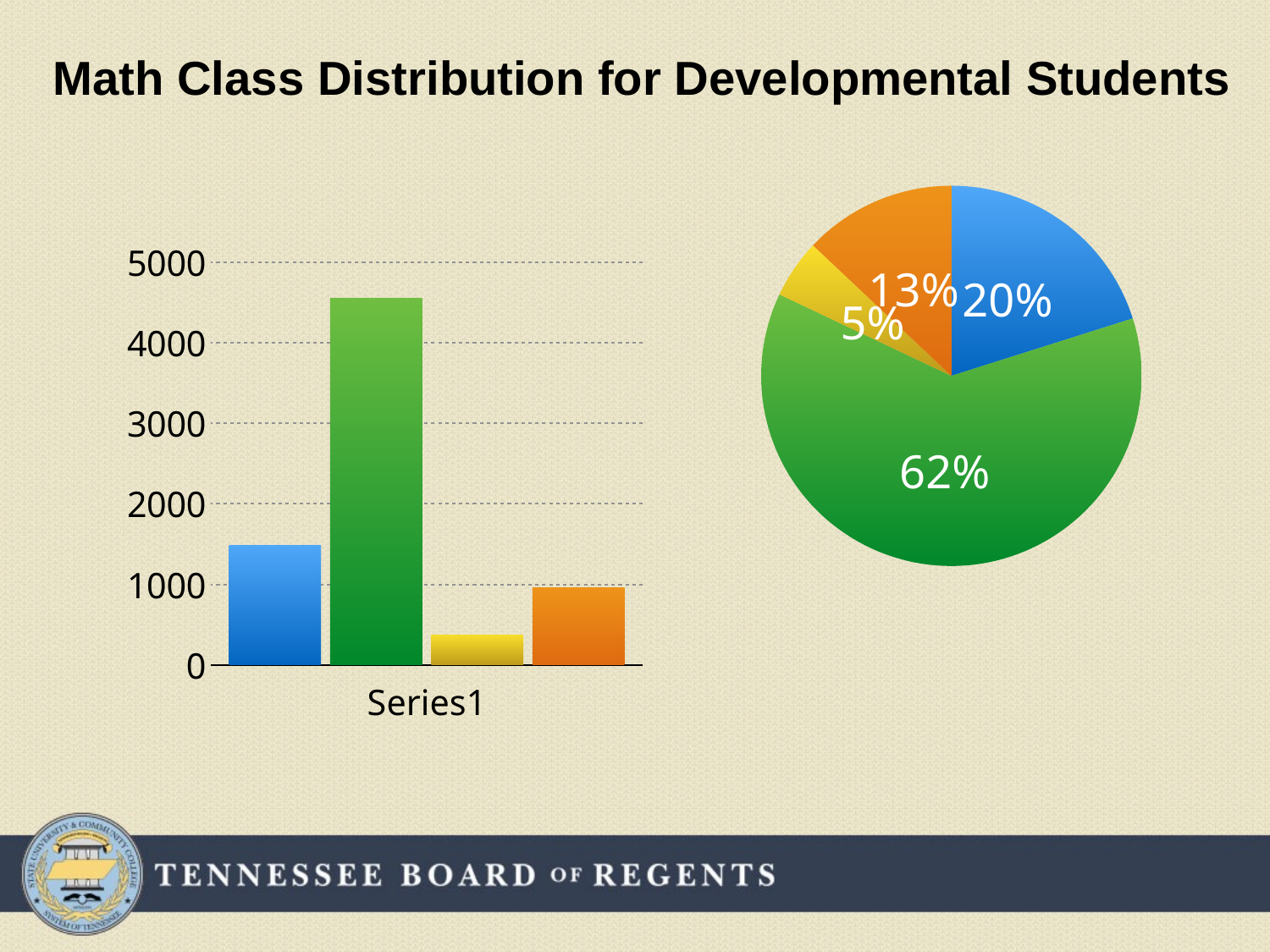
In the pie chart on the right, what percentage is shown on the blue slice? 20% In the pie chart on the right, how many slices are there? 4 What kind of chart is on the left side of the slide? bar chart In the bar chart on the left, is the value of the yellow bar greater or less than 1000? less In the pie chart on the right, what is the difference between the green slice's share and the blue slice's share? 42% In the bar chart on the left, how many bars are plotted? 4 In the pie chart on the right, which colour slice has the largest share? green What kind of chart is on the right side of the slide? pie chart In the pie chart on the right, which colour slice has the smallest share? yellow In the pie chart on the right, what percentage is shown on the yellow slice? 5% In the pie chart on the right, what percentage is shown on the green slice? 62% In the bar chart on the left, is the value of the green bar greater or less than 4000? greater